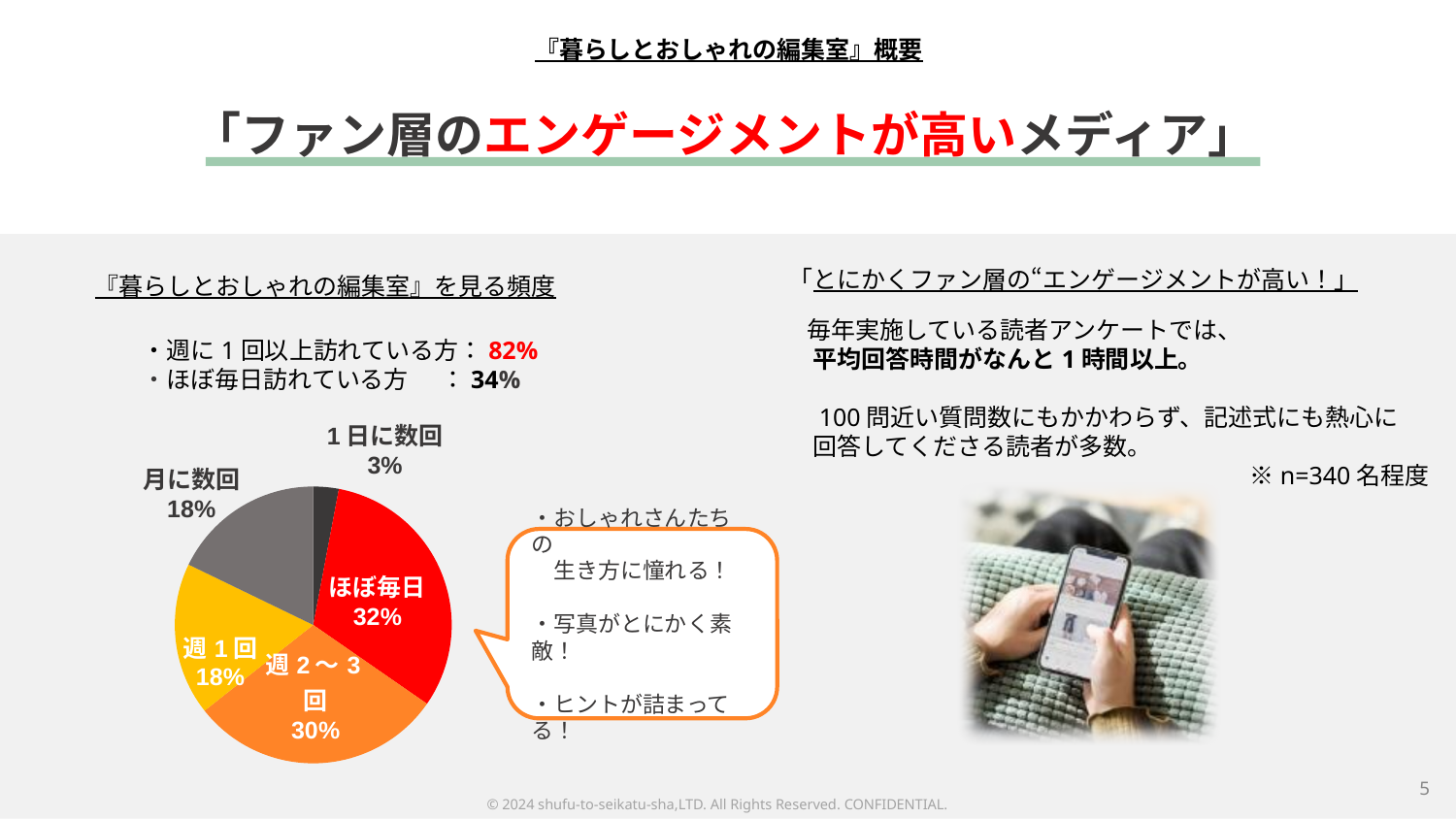
What share of the pie chart is labelled 1日に数回? 3% Which slice of the pie chart is the smallest? 1日に数回 What share of the pie chart is labelled ほぼ毎日? 32% What kind of chart is shown on the slide? pie chart What share of the pie chart is labelled 週2〜3回? 30% How many slices does the pie chart have? 5 Which slice of the pie chart is the largest? ほぼ毎日 What share of the pie chart is labelled 月に数回? 18% What is the combined share of the ほぼ毎日 and 1日に数回 slices? 35% Which is larger in the pie chart, 週1回 or 1日に数回? 週1回 What colour is the ほぼ毎日 slice of the pie chart? red What is the difference in percentage points between the ほぼ毎日 slice and the 週2〜3回 slice? 2